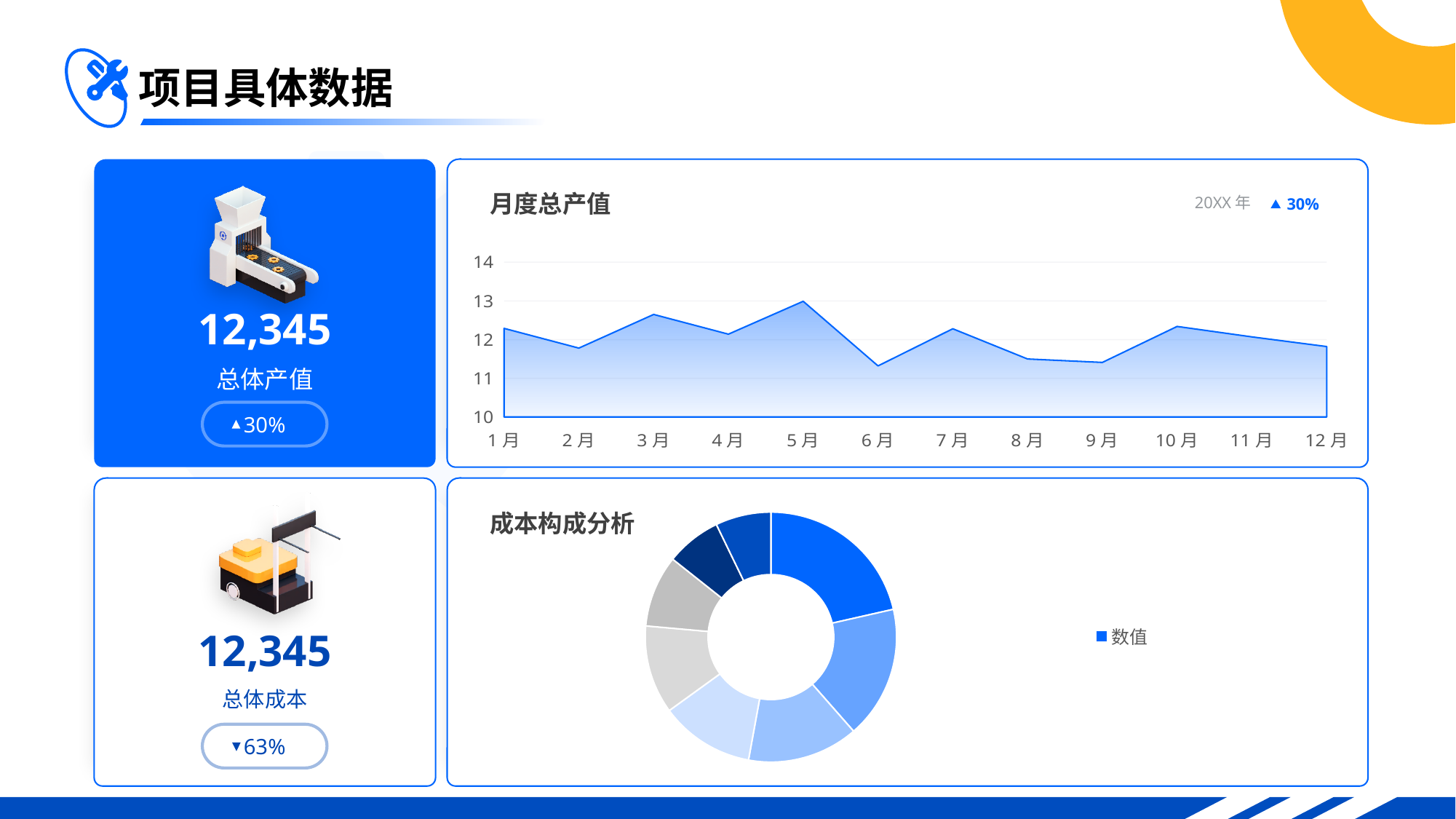
How many series does the legend of the 成本构成分析 chart list? 1 In the 月度总产值 chart, which is larger, the value for 5 月 or the value for 6 月? 5 月 In the 月度总产值 chart, is the value for 8 月 greater or less than 12? less In the 月度总产值 chart, which month has the highest value? 5 月 In the 月度总产值 chart, is the value for 6 月 greater or less than 12? less In the 月度总产值 chart, is the value for 5 月 greater or less than 12? greater What kind of chart is the 月度总产值 chart? area chart In the 月度总产值 chart, do the values rise or fall from 10 月 to 12 月? fall In the 月度总产值 chart, how many months are plotted on the x axis? 12 How many slices does the 成本构成分析 doughnut chart have? 8 What kind of chart is the 成本构成分析 chart? doughnut chart